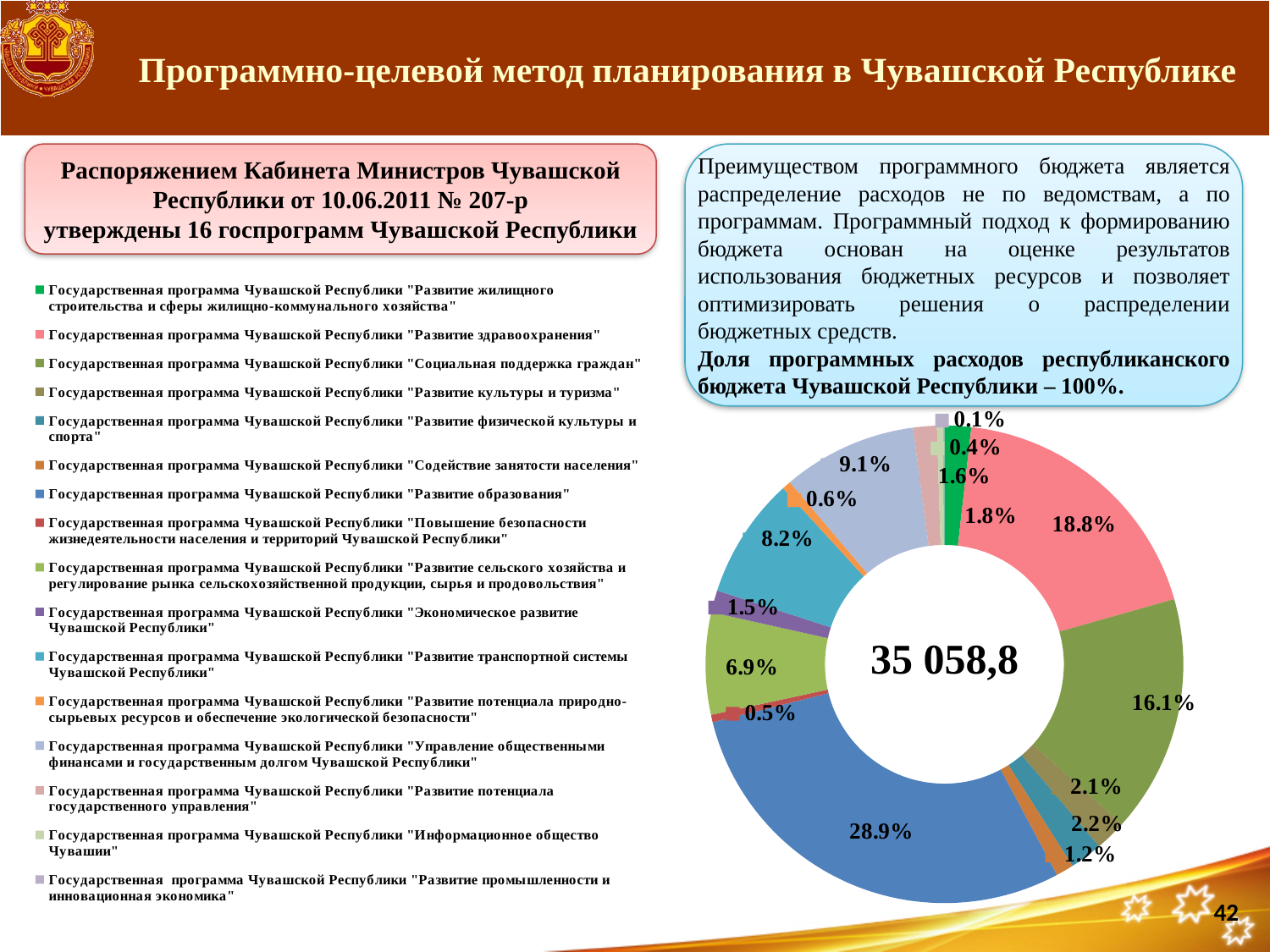
What is the combined share of the two largest slices, 28.9% and 18.8%? 47.7% How many slices does the doughnut chart contain? 16 What kind of chart is shown on the right side of the slide? Doughnut (pie) chart What share does the programme "Социальная поддержка граждан" (olive-green slice) have in the doughnut chart? 16.1% What value is printed in the centre of the doughnut chart? 35 058,8 What share does the programme "Развитие образования" (blue slice) have in the doughnut chart? 28.9% What is the largest share shown in the doughnut chart? 28.9% What is the smallest share shown in the doughnut chart? 0.1% What share does the programme "Развитие здравоохранения" (pink slice) have in the doughnut chart? 18.8% Which slice is larger: the one labelled 16.1% or the one labelled 18.8%? 18.8% What is the difference in percentage points between the largest slice (28.9%) and the second largest slice (18.8%)? 10.1 How many state programmes are listed in the legend on the left of the slide? 16